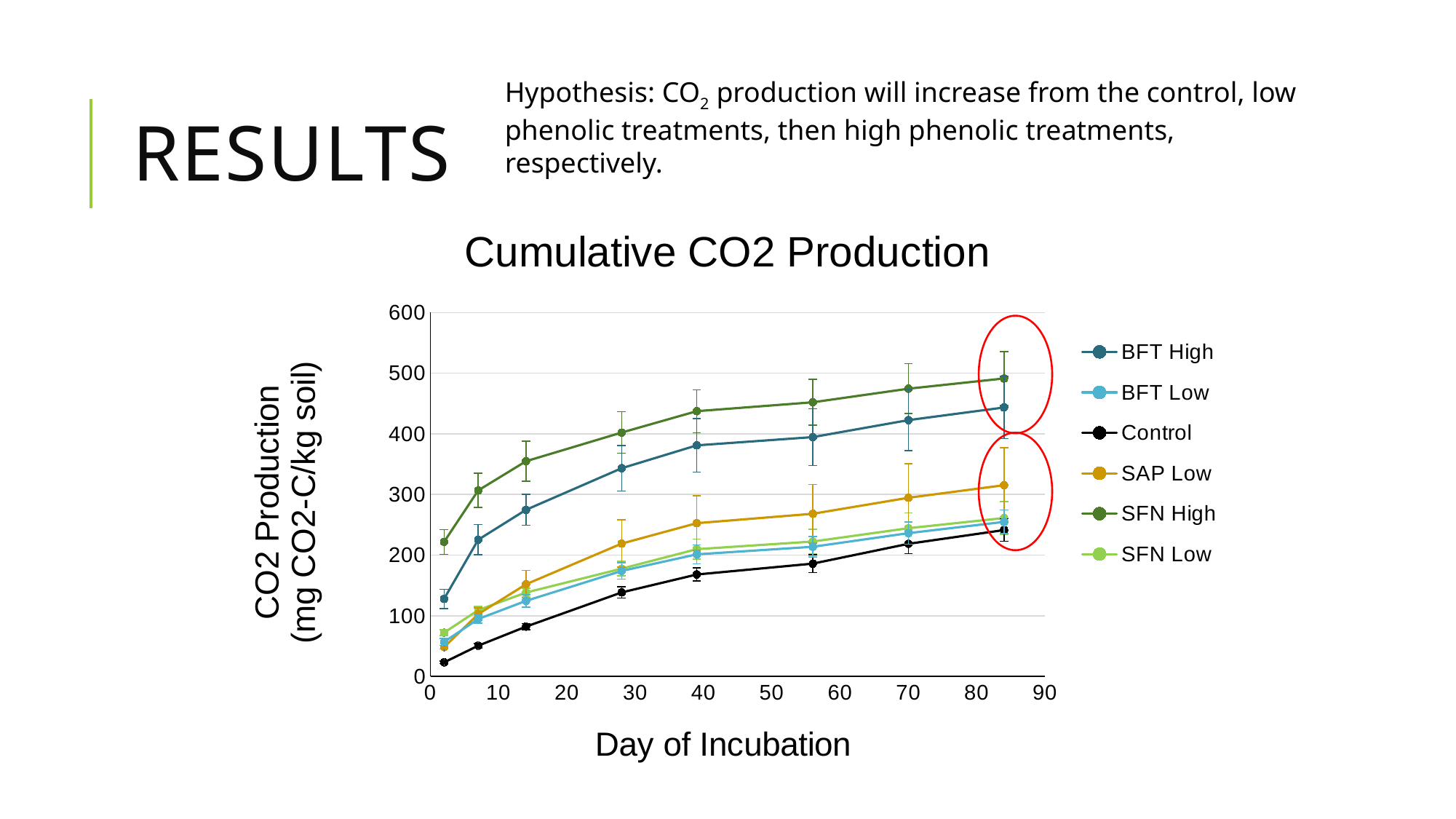
Does the Control series rise or fall as the day of incubation increases? rise What kind of chart is shown on the slide? line chart Which series has the lowest CO2 production at day 84? Control How many series does the legend list? 6 Is the value for SAP Low at day 84 greater or less than 400? less At day 84, which is larger: BFT High or SAP Low? BFT High Is the value for BFT High at day 2 greater or less than 200? less Which series has the highest CO2 production at day 84? SFN High At day 14, which is larger: SFN High or BFT High? SFN High What is the title of the chart? Cumulative CO2 Production Is the value for SFN High at day 84 greater or less than 400? greater